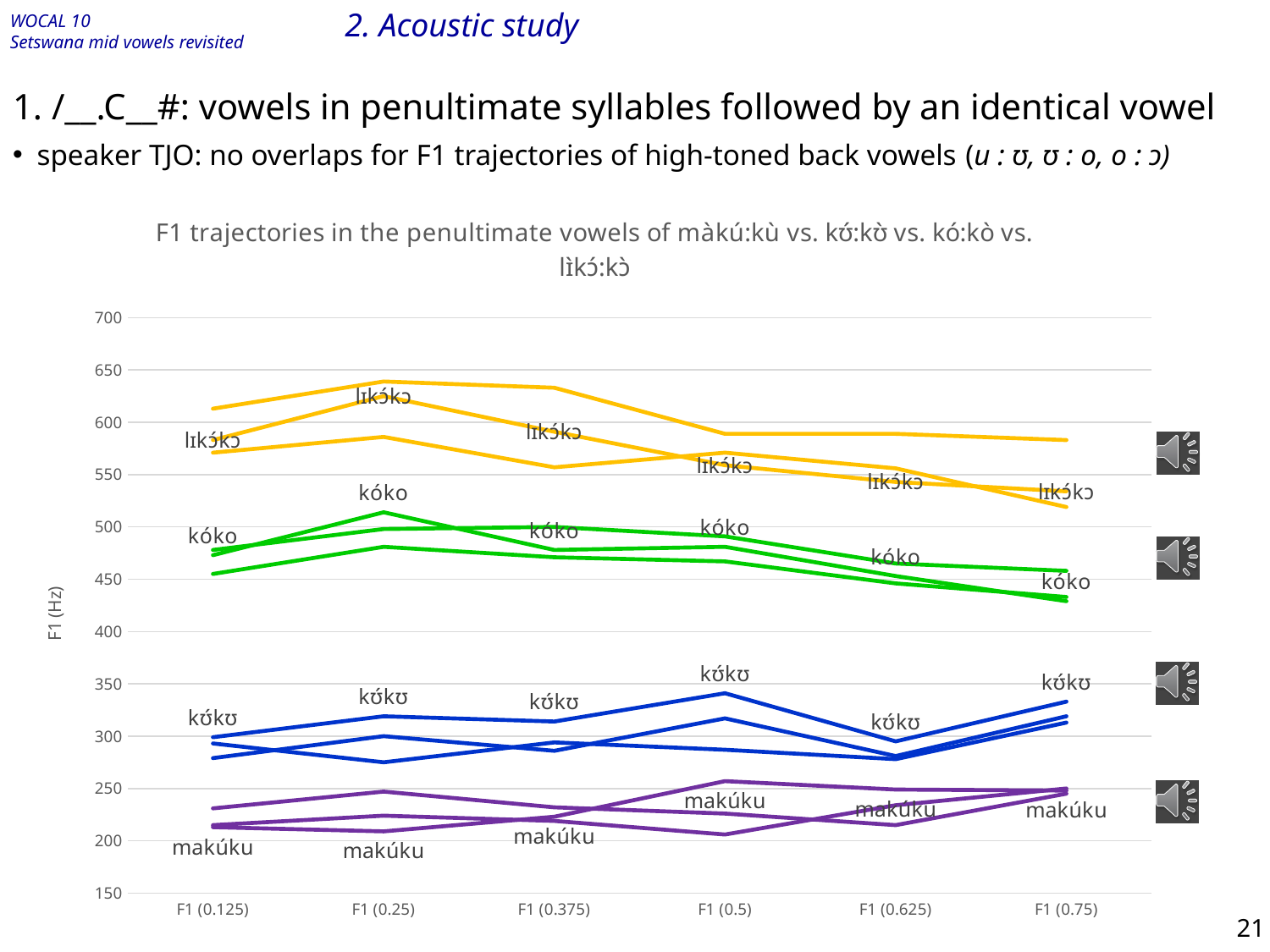
What colour are the lines for makúku in the chart? purple Do the F1 values for lɪkɔ́kɔ rise or fall from F1 (0.25) to F1 (0.75)? fall Are the F1 values for lɪkɔ́kɔ at F1 (0.25) greater or less than 550? greater Which word has the lowest F1 trajectories in the chart? makúku At F1 (0.5), which word has higher F1 values, kóko or kʊ́kʊ? kóko What kind of chart is shown on the slide? line chart What is the label of the y axis of the chart? F1 (Hz) Are the F1 values for kóko at F1 (0.125) greater or less than 500? less Which word has the highest F1 trajectories in the chart? lɪkɔ́kɔ Are the F1 values for makúku at F1 (0.5) greater or less than 300? less How many time points are shown along the x axis of the chart? 6